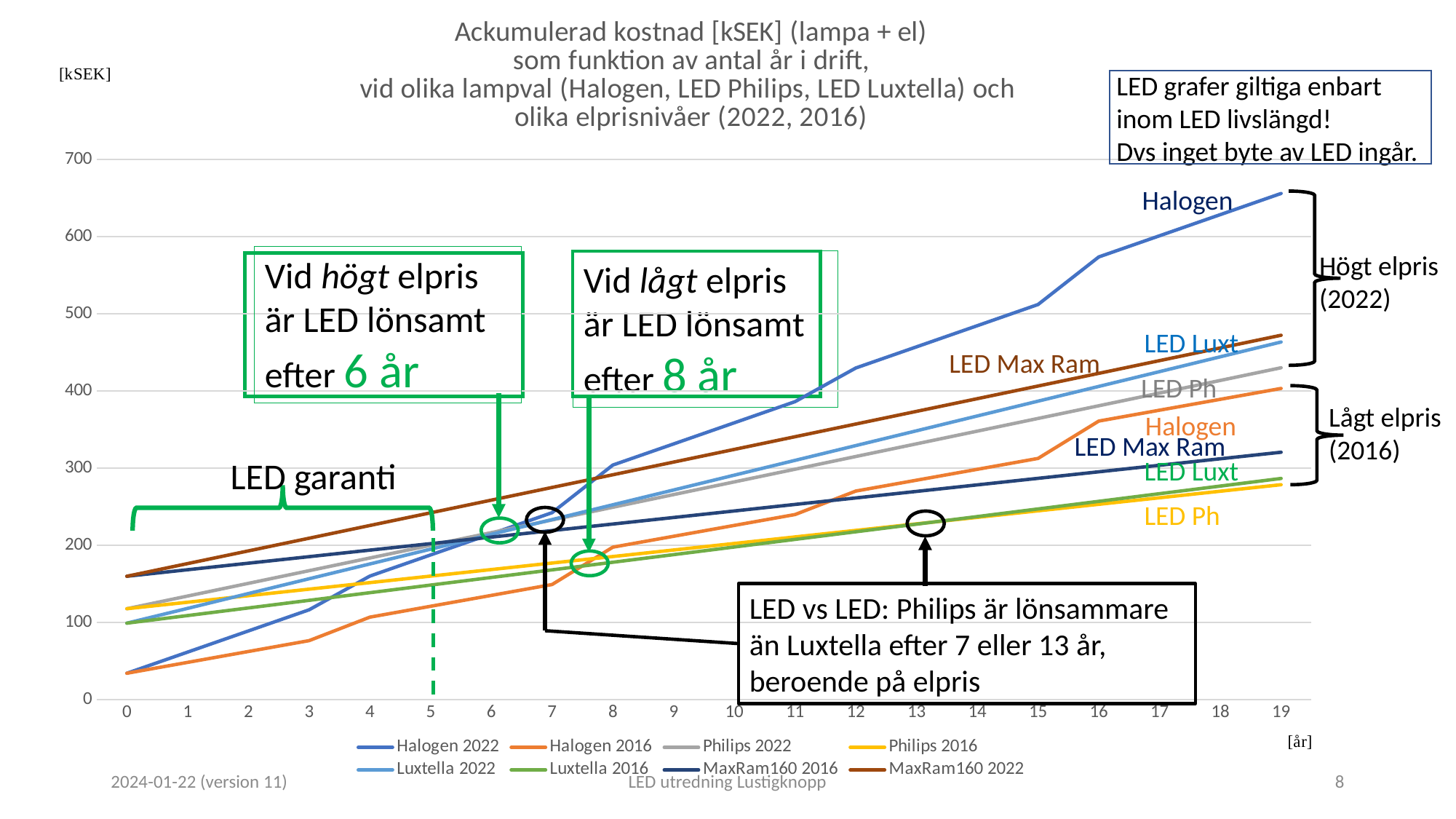
Is the value for MaxRam160 2022 at year 0 greater or less than 200? less Do the values of the Halogen 2022 series rise or fall as the number of years increases? rise Is the value for Halogen 2022 at year 19 greater or less than 600? greater Is the value for Halogen 2016 at year 0 greater or less than 100? less What kind of chart is shown on the slide? line chart How many year values are shown on the x axis? 20 Which series has the highest value at year 0? MaxRam160 2022 and MaxRam160 2016 (tied at 160) How many series does the legend list? 8 What unit is shown on the y axis of the chart? [kSEK] Which series has the highest value at year 19? Halogen 2022 At year 19, which is larger: Halogen 2022 or Halogen 2016? Halogen 2022